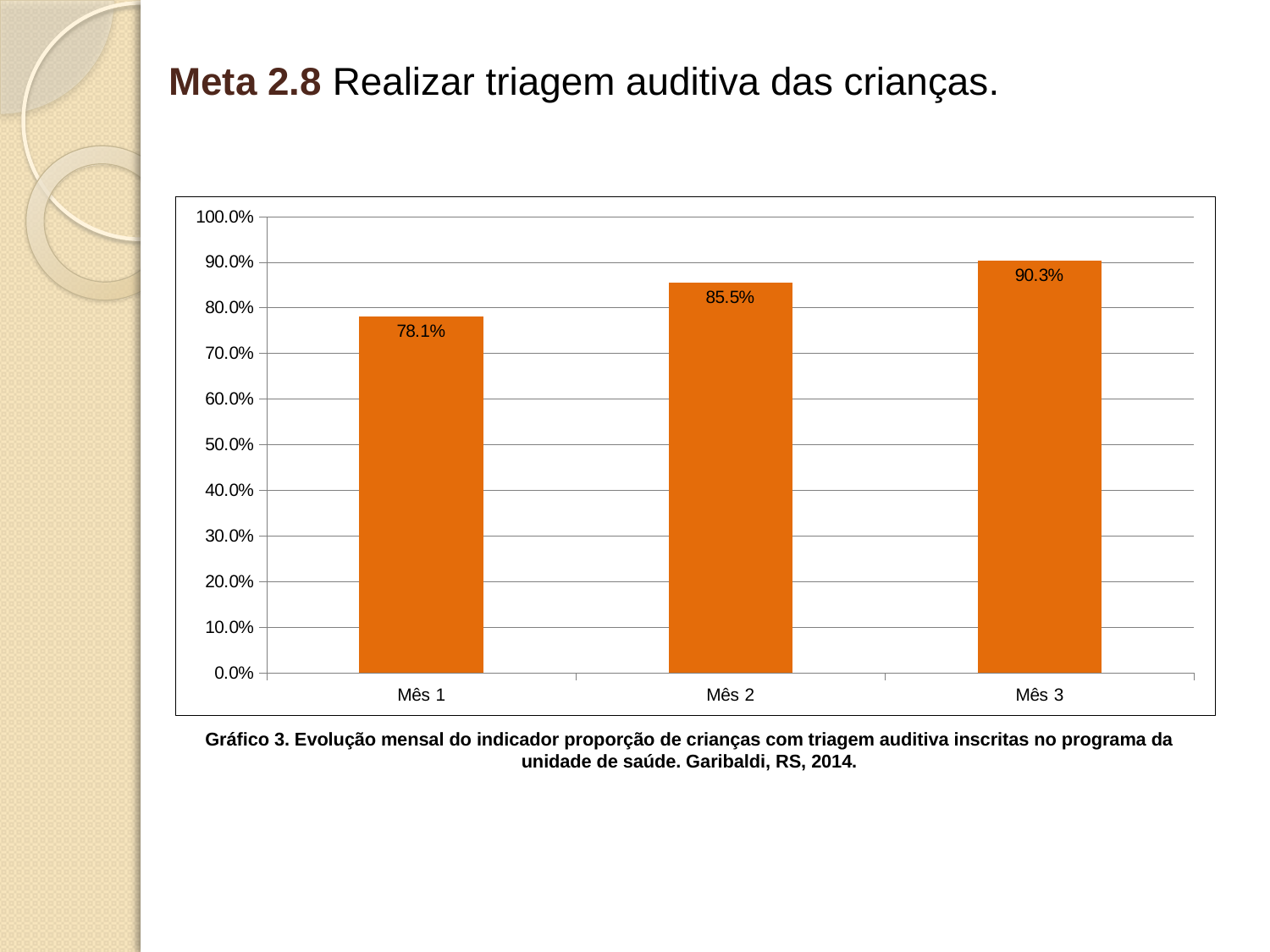
What kind of chart is shown on the slide? bar chart Which month has the lowest value? Mês 1 Which is larger, the value for Mês 2 or the value for Mês 3? Mês 3 What is the value for Mês 1? 78.1% What is the value for Mês 2? 85.5% Do the values rise or fall from Mês 1 to Mês 3? rise What is the difference between the values for Mês 2 and Mês 1? 7.4% How many months are shown on the x axis? 3 Is the value for Mês 1 greater or less than 80.0%? less What is the difference between the values for Mês 3 and Mês 1? 12.2% Which month has the highest value? Mês 3 What is the value for Mês 3? 90.3%